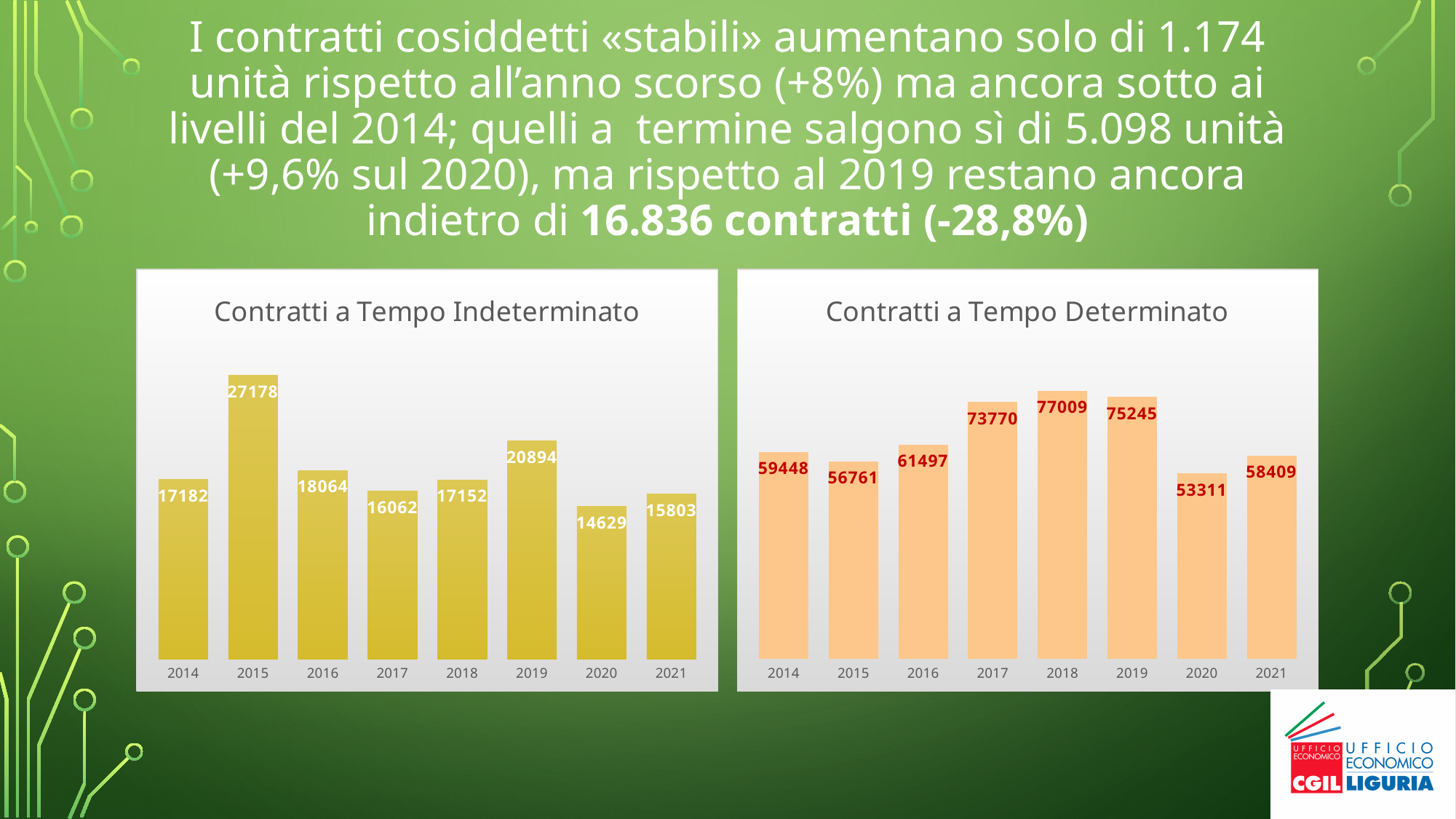
In the 'Contratti a Tempo Determinato' chart, what is the difference between the 2019 and 2021 values? 16836 In the 'Contratti a Tempo Determinato' chart, what is the value for 2020? 53311 In the 'Contratti a Tempo Indeterminato' chart, what is the difference between the 2021 and 2020 values? 1174 In the 'Contratti a Tempo Determinato' chart, which is larger, the value for 2014 or the value for 2015? 2014 How many years are shown in the 'Contratti a Tempo Determinato' chart? 8 What is the title of the chart on the right side of the slide? Contratti a Tempo Determinato In the 'Contratti a Tempo Indeterminato' chart, which year has the lowest value? 2020 In the 'Contratti a Tempo Determinato' chart, do the values rise or fall from 2019 to 2020? Fall What kind of chart is the 'Contratti a Tempo Indeterminato' chart? Bar chart In the 'Contratti a Tempo Indeterminato' chart, which is larger, the value for 2016 or the value for 2019? 2019 In the 'Contratti a Tempo Determinato' chart, which year has the highest value? 2018 In the 'Contratti a Tempo Indeterminato' chart, what is the value for 2015? 27178